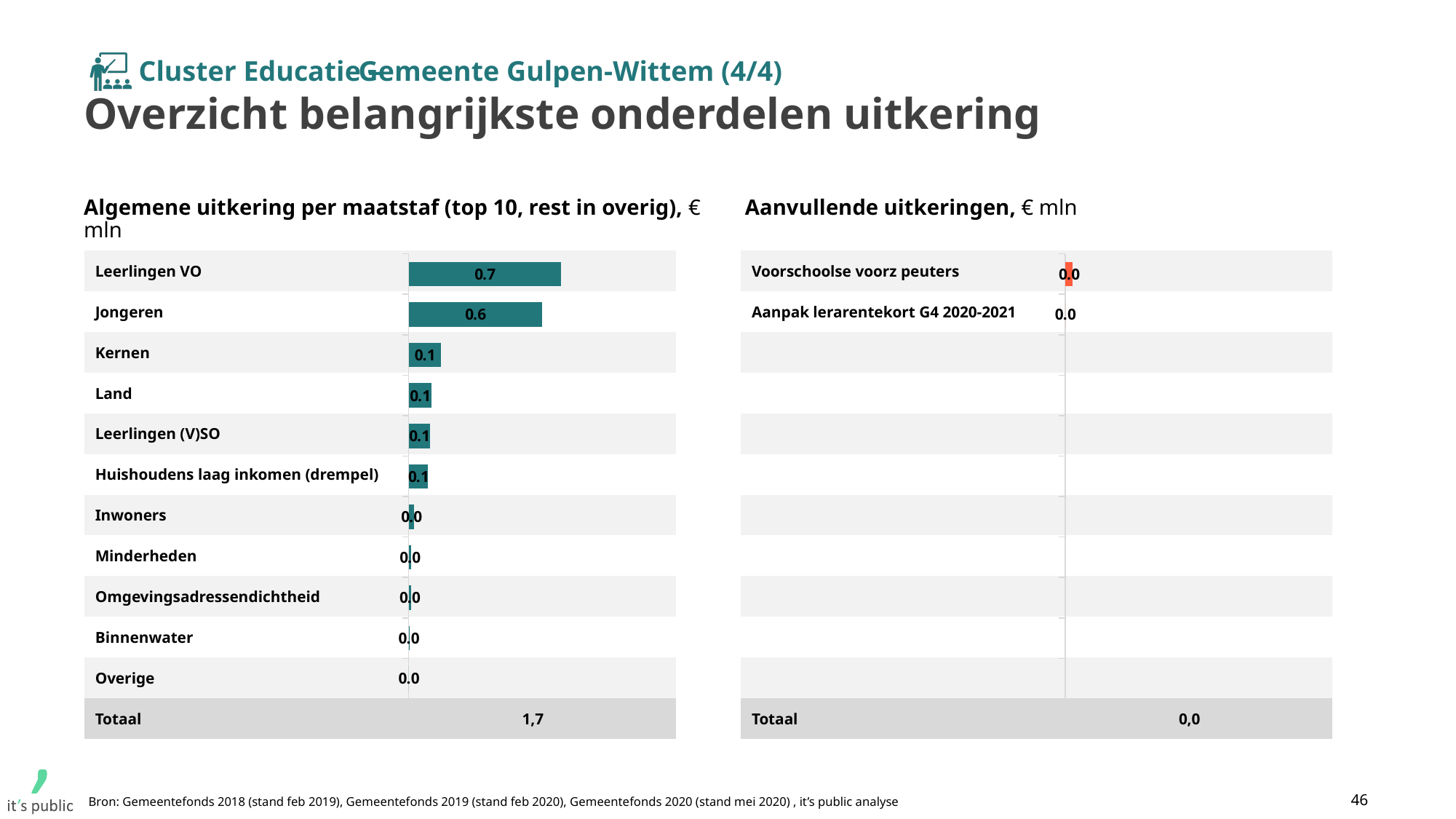
What is the Totaal shown for the chart 'Algemene uitkering per maatstaf'? 1,7 In the chart 'Algemene uitkering per maatstaf', which is larger: the value for Jongeren or the value for Land? Jongeren How many categories are listed in the chart 'Aanvullende uitkeringen' (excluding the Totaal row)? 2 What unit is stated in the title of the chart 'Aanvullende uitkeringen'? € mln How many categories are listed in the chart 'Algemene uitkering per maatstaf' (excluding the Totaal row)? 11 What kind of chart is 'Algemene uitkering per maatstaf'? Bar chart In the chart 'Algemene uitkering per maatstaf', which category has the highest value? Leerlingen VO In the chart 'Algemene uitkering per maatstaf', what is the difference between the values for Leerlingen VO and Jongeren? 0.1 In the chart 'Aanvullende uitkeringen', what is the value for Voorschoolse voorz peuters? 0.0 In the chart 'Algemene uitkering per maatstaf', what is the value for Leerlingen VO? 0.7 In the chart 'Algemene uitkering per maatstaf', what is the value for Jongeren? 0.6 In the chart 'Algemene uitkering per maatstaf', what is the value for Kernen? 0.1